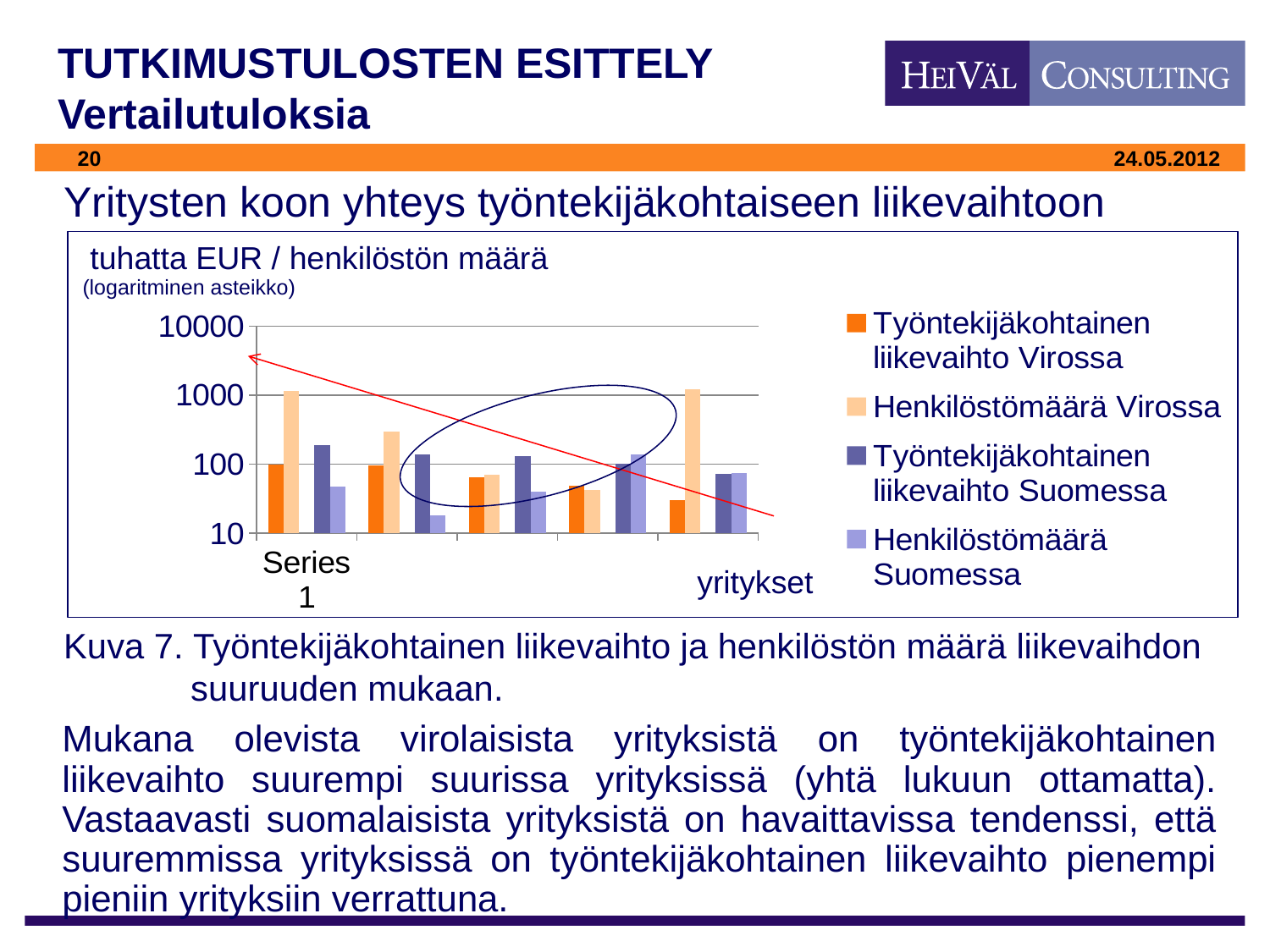
In the Series 1 group, which is larger: Henkilöstömäärä Virossa or Henkilöstömäärä Suomessa? Henkilöstömäärä Virossa How many groups of bars are plotted along the x axis? 5 Which series has the tallest bar in the Series 1 group? Henkilöstömäärä Virossa In the Series 1 group, is the value for Henkilöstömäärä Suomessa greater or less than 100? less What kind of scale does the chart's vertical axis use, according to the note above the chart? logarithmic (logaritminen asteikko) In the Series 1 group, is the value for Työntekijäkohtainen liikevaihto Suomessa greater or less than 100? greater In the Series 1 group, which is larger: Työntekijäkohtainen liikevaihto Suomessa or Työntekijäkohtainen liikevaihto Virossa? Työntekijäkohtainen liikevaihto Suomessa In the Series 1 group, is the value for Henkilöstömäärä Virossa greater or less than 1000? greater How many series does the chart legend list? 4 Which series has the shortest bar in the Series 1 group? Henkilöstömäärä Suomessa What is the label shown on the chart's x axis? yritykset What kind of chart is shown on the slide? bar chart